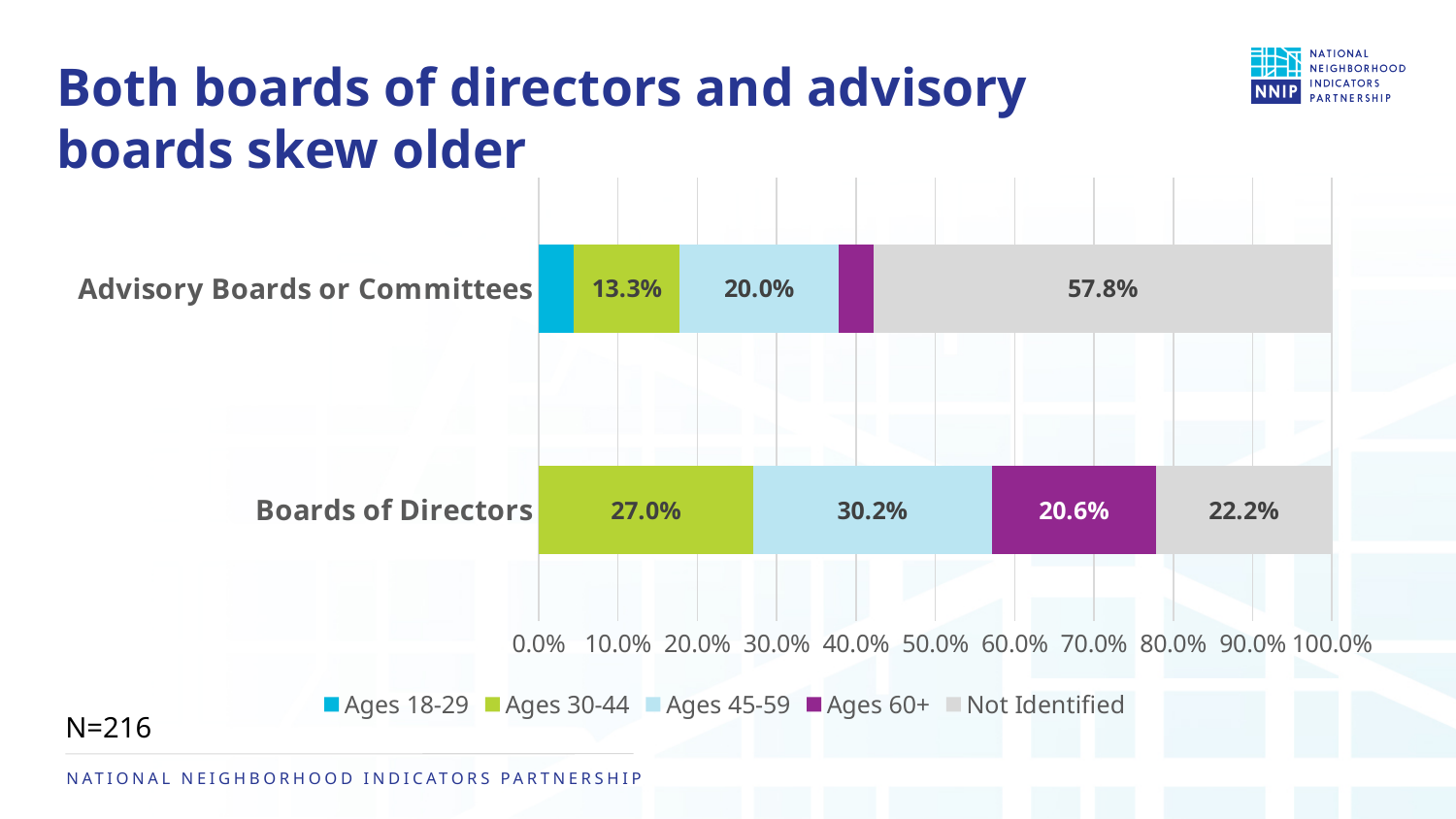
What is the Ages 60+ share for Boards of Directors? 20.6% How many series does the legend list? 5 Which is larger: the Ages 30-44 share for Boards of Directors or for Advisory Boards or Committees? Boards of Directors How many categories (bars) are plotted in the chart? 2 Is the Ages 18-29 share for Advisory Boards or Committees greater or less than 10.0%? less Which age group has the largest labelled share for Boards of Directors? Ages 45-59 What is the total of the labelled segments for the Boards of Directors bar? 100.0% What is the Ages 45-59 share for Boards of Directors? 30.2% What is the Ages 30-44 share for Advisory Boards or Committees? 13.3% What is the difference between the Not Identified shares for Advisory Boards or Committees and Boards of Directors? 35.6% What is the Not Identified share for Advisory Boards or Committees? 57.8% What kind of chart is shown on the slide? Stacked bar chart